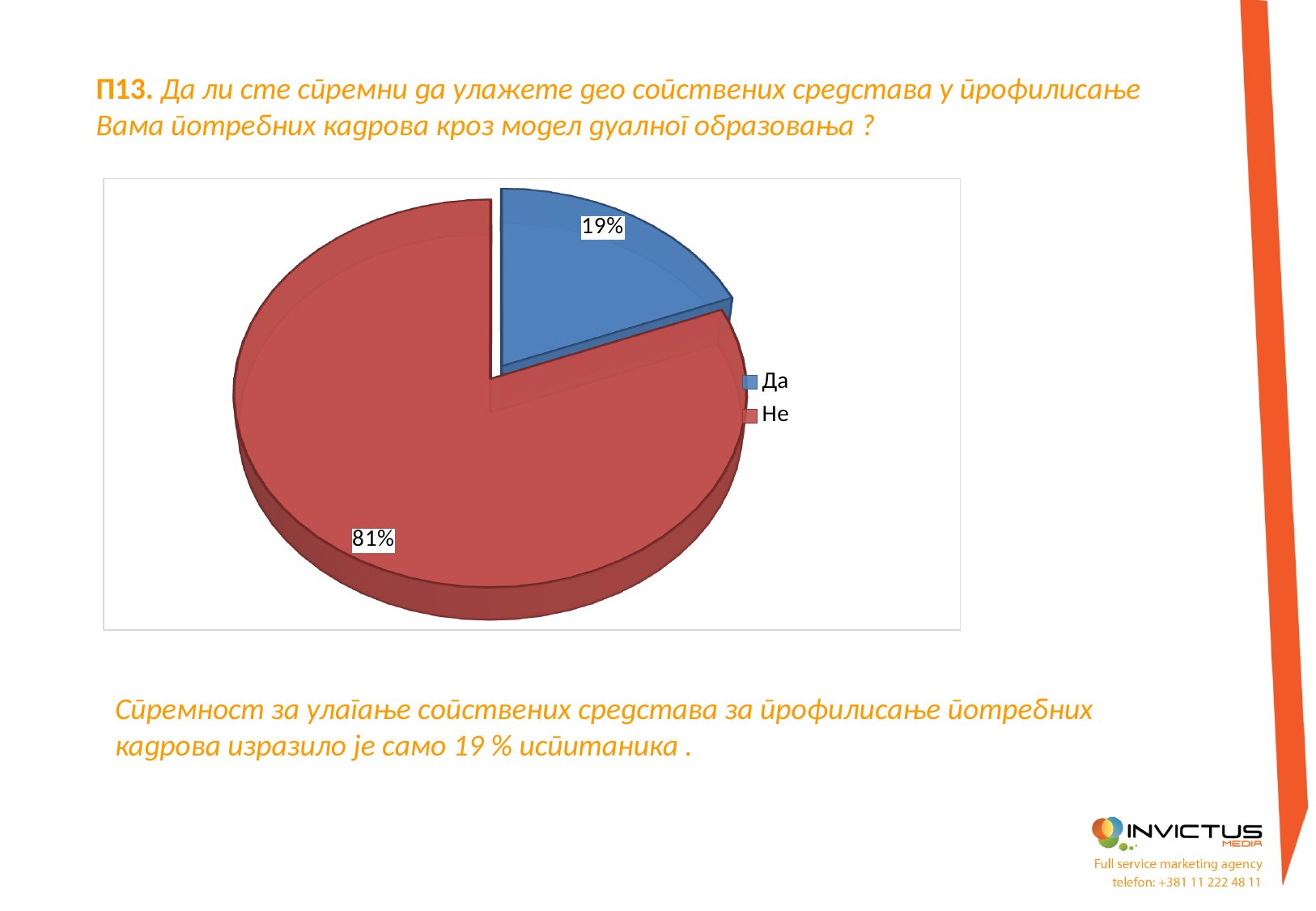
How many entries does the legend list? 2 What is the difference in percentage points between the "Не" slice and the "Да" slice? 62 How many slices does the pie chart have? 2 Which slice of the pie is the largest? Не Which slice of the pie is the smallest? Да What colour is the "Да" slice in the pie chart? blue What share of the pie does the "Да" slice represent? 19% What kind of chart is shown on the slide? pie chart What share of the pie does the "Не" slice represent? 81% Which is larger, the "Да" slice or the "Не" slice? Не What colour is the "Не" slice in the pie chart? red